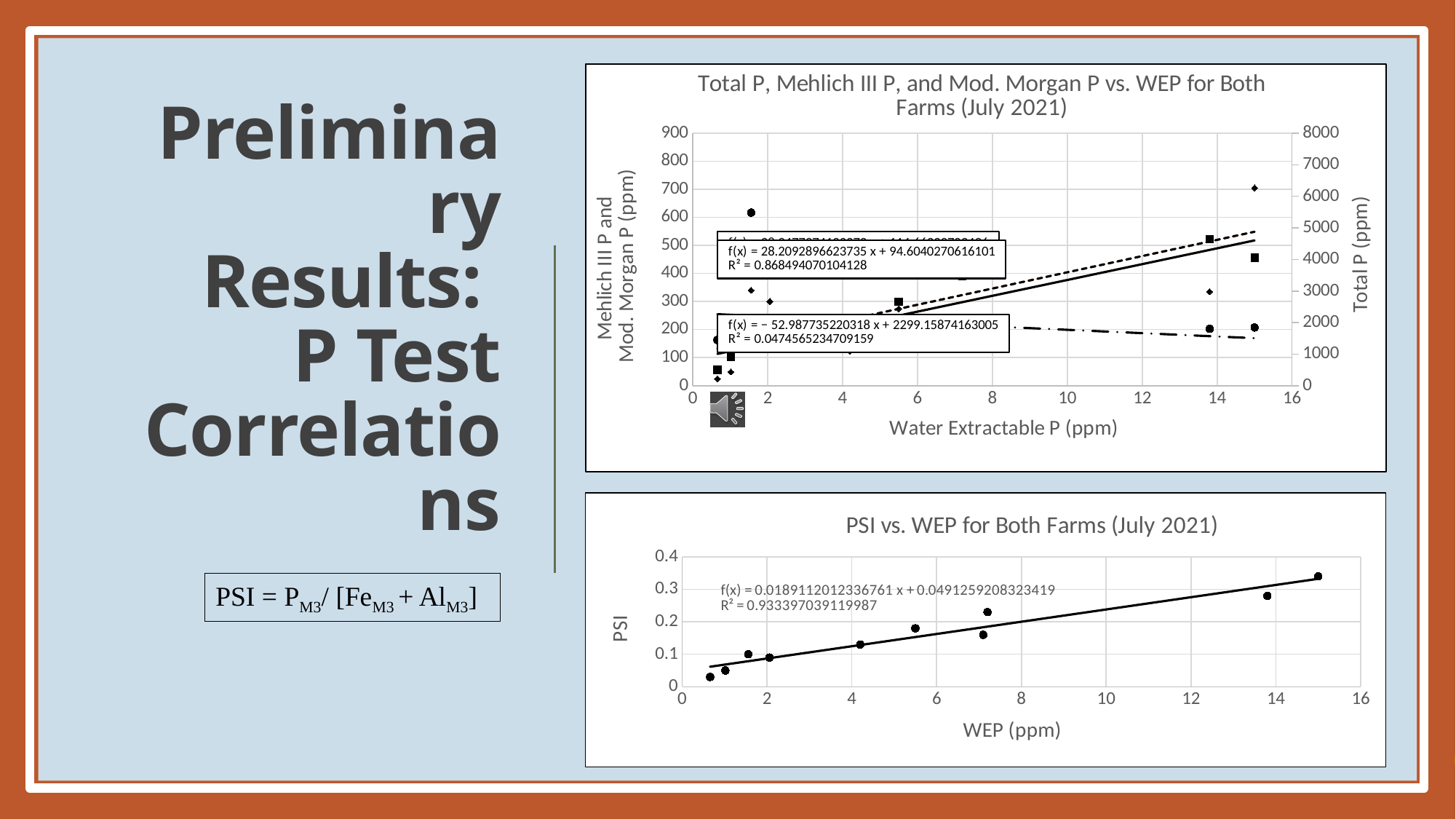
In the bottom chart 'PSI vs. WEP for Both Farms (July 2021)', does PSI generally rise or fall as WEP increases? Rise What kind of chart is the top chart, 'Total P, Mehlich III P, and Mod. Morgan P vs. WEP for Both Farms (July 2021)'? Scatter chart In the bottom chart 'PSI vs. WEP for Both Farms (July 2021)', is the PSI value of the point at about 15 ppm WEP greater or less than 0.3? greater In the bottom chart 'PSI vs. WEP for Both Farms (July 2021)', how many data points are plotted? 10 What is the label of the right-hand vertical axis in the top chart? Total P (ppm) In the top chart, does the dash-dot trendline rise or fall as Water Extractable P increases? Fall In the bottom chart 'PSI vs. WEP for Both Farms (July 2021)', what is the R² value printed for the trendline? 0.933397039119987 What kind of chart is the bottom chart, 'PSI vs. WEP for Both Farms (July 2021)'? Scatter chart In the top chart, what is the R² value printed for the trendline with equation f(x) = 28.2092896623735 x + 94.6040270616101? 0.868494070104128 In the top chart, what is the R² value printed for the trendline with equation f(x) = − 52.987735220318 x + 2299.15874163005? 0.0474565234709159 In the bottom chart 'PSI vs. WEP for Both Farms (July 2021)', what is the trendline equation printed on the chart? f(x) = 0.0189112012336761 x + 0.0491259208323419 In the bottom chart 'PSI vs. WEP for Both Farms (July 2021)', is the PSI value of the point at about 4 ppm WEP greater or less than 0.2? less